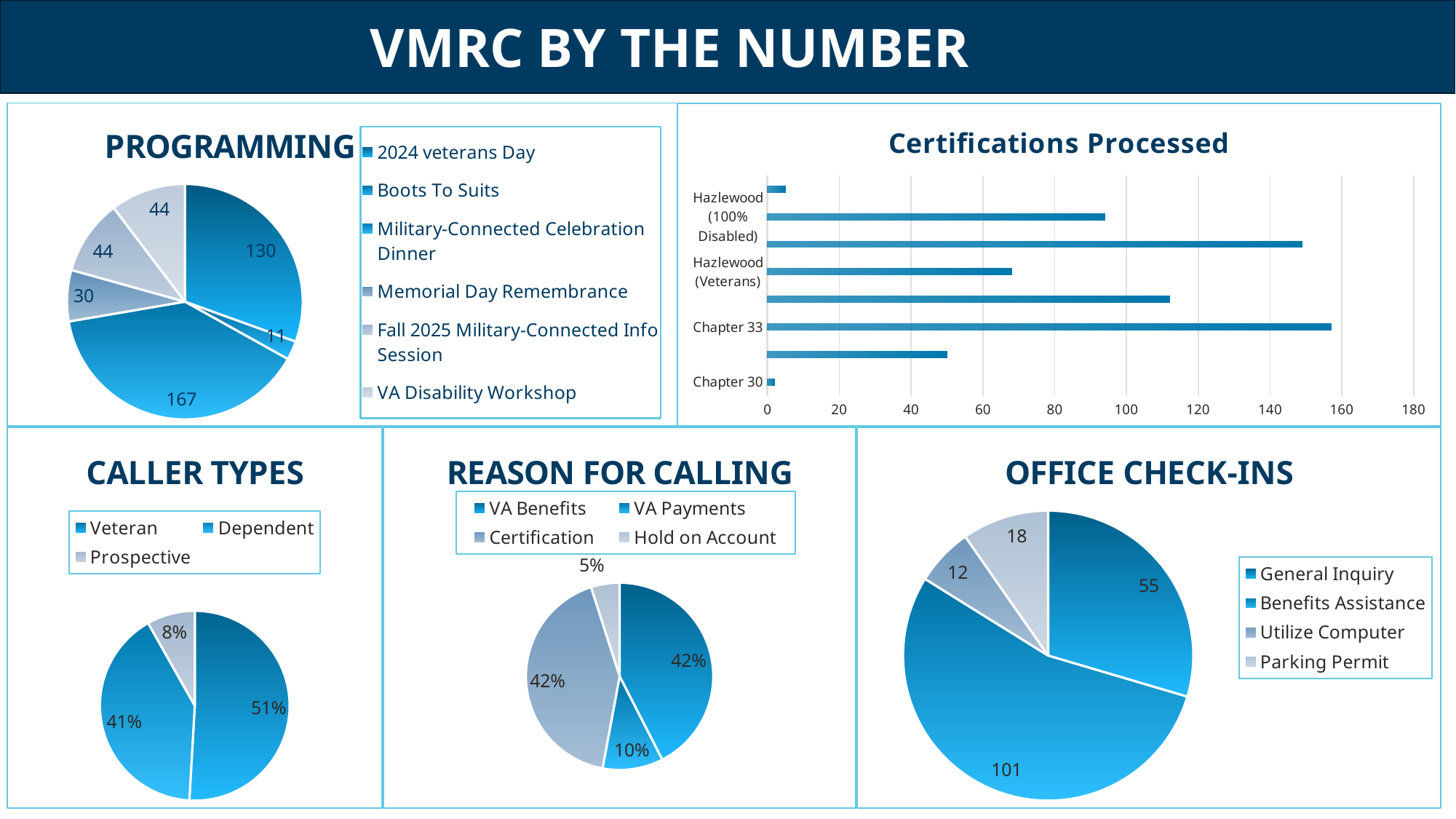
In the CALLER TYPES pie chart, which category has the largest share? Veteran How many categories are shown on the vertical axis of the Certifications Processed chart? 4 In the OFFICE CHECK-INS pie chart, what is the value for Benefits Assistance? 101 In the CALLER TYPES pie chart, what share is Dependent? 41% In the PROGRAMMING pie chart, which category has the smallest value? Boots To Suits How many entries does the legend of the REASON FOR CALLING chart list? 4 In the PROGRAMMING pie chart, what is the value for Military-Connected Celebration Dinner? 167 In the REASON FOR CALLING pie chart, what share is VA Payments? 10% What kind of chart is the Certifications Processed chart? bar chart In the OFFICE CHECK-INS pie chart, which is larger, Utilize Computer or Parking Permit? Parking Permit In the PROGRAMMING pie chart, what is the difference between the values for 2024 veterans Day and Memorial Day Remembrance? 100 In the Certifications Processed chart, is the value of the bar next to the Chapter 30 label greater or less than 20? less